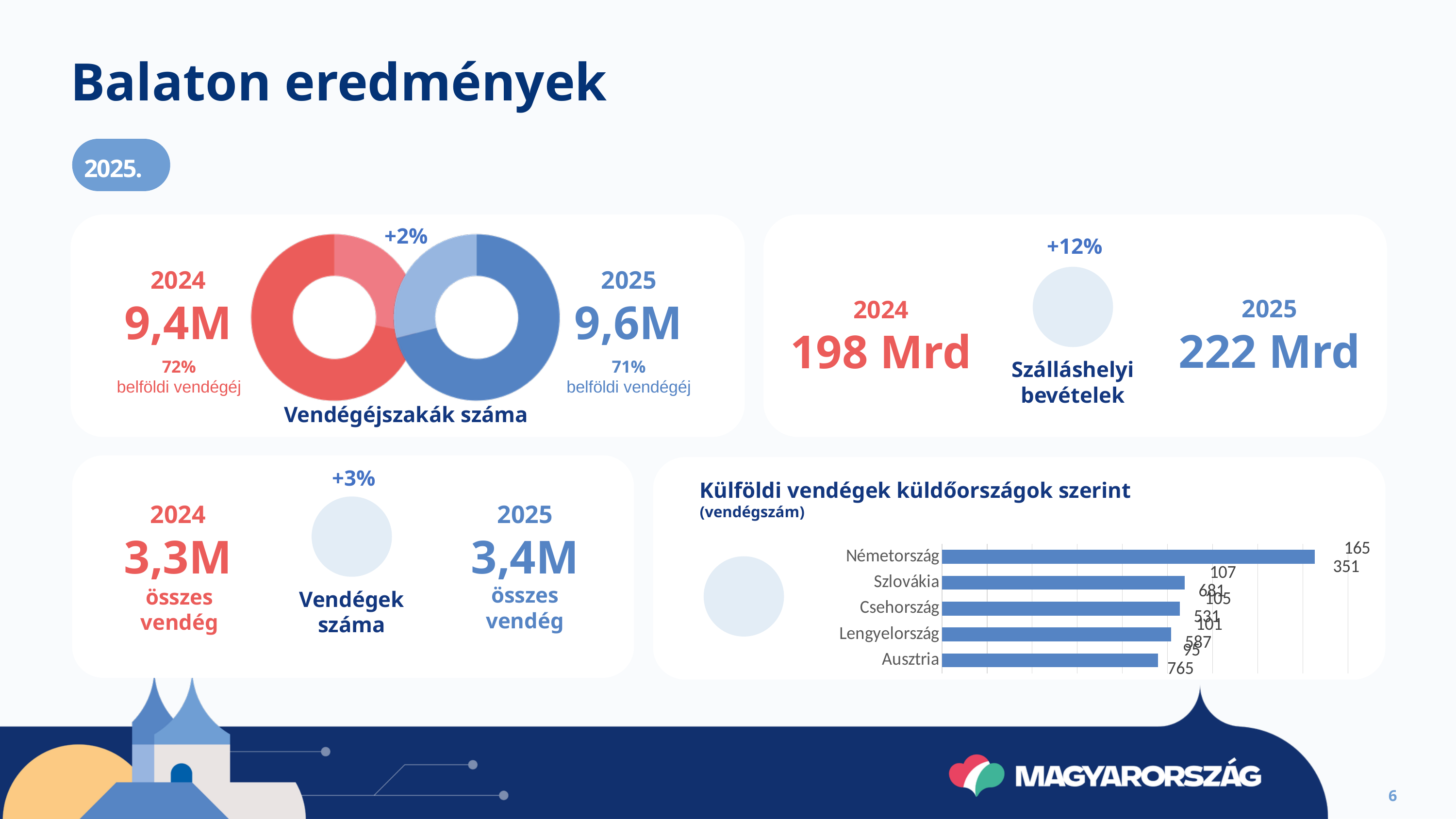
What kind of charts are used for 'Vendégéjszakák száma'? donut charts In the 'Külföldi vendégek küldőországok szerint' bar chart, which country has the lowest value? Ausztria In the 'Külföldi vendégek küldőországok szerint' bar chart, which is larger, the value for Németország or the value for Ausztria? Németország In the 'Külföldi vendégek küldőországok szerint' bar chart, what is the value for Németország? 165 351 What percentage change is shown above the two donut charts for 'Vendégéjszakák száma'? +2% In the 2025 donut chart for 'Vendégéjszakák száma', what share is 'belföldi vendégéj'? 71% What kind of chart is the 'Külföldi vendégek küldőországok szerint' chart? bar chart In the 2024 donut chart for 'Vendégéjszakák száma', what share is 'belföldi vendégéj'? 72% In the 'Külföldi vendégek küldőországok szerint' bar chart, do the values rise or fall going from the top bar to the bottom bar? fall What is the subtitle in parentheses under the title of the 'Külföldi vendégek küldőországok szerint' bar chart? (vendégszám) How many countries are shown in the 'Külföldi vendégek küldőországok szerint' bar chart? 5 In the 'Külföldi vendégek küldőországok szerint' bar chart, which country has the highest value? Németország